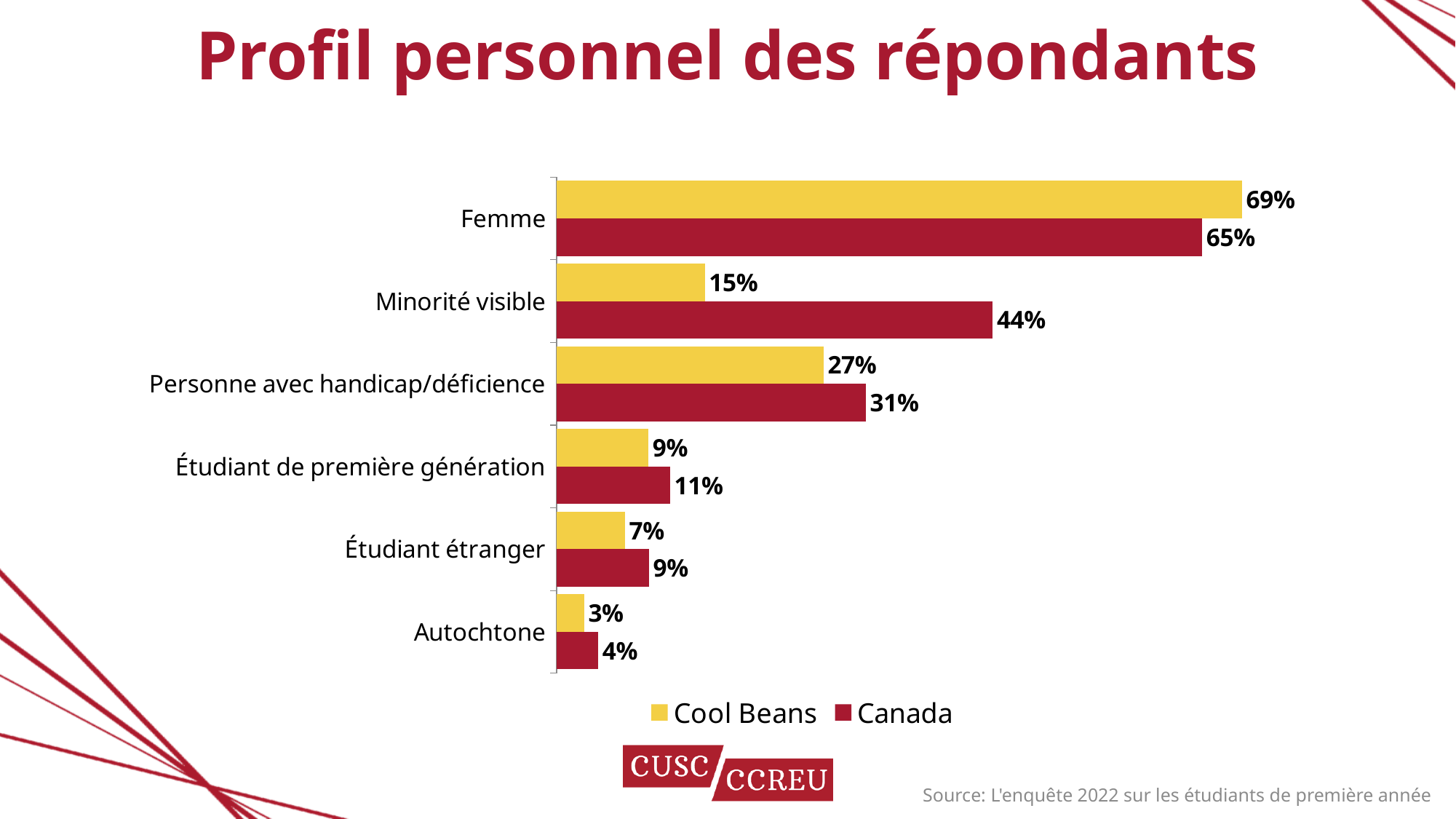
What is the Canada value for Étudiant étranger? 9% Which category has the lowest Canada value? Autochtone What kind of chart is shown on the slide? Bar chart Which category has the highest Cool Beans value? Femme What is the difference between the Canada and Cool Beans values for Minorité visible? 29% What is the Cool Beans value for Personne avec handicap/déficience? 27% Which is larger for Femme, the Cool Beans value or the Canada value? Cool Beans How many categories are shown on the chart? 6 What is the Cool Beans value for Femme? 69% What is the title of the chart? Profil personnel des répondants How many series does the legend list? 2 What is the Canada value for Minorité visible? 44%